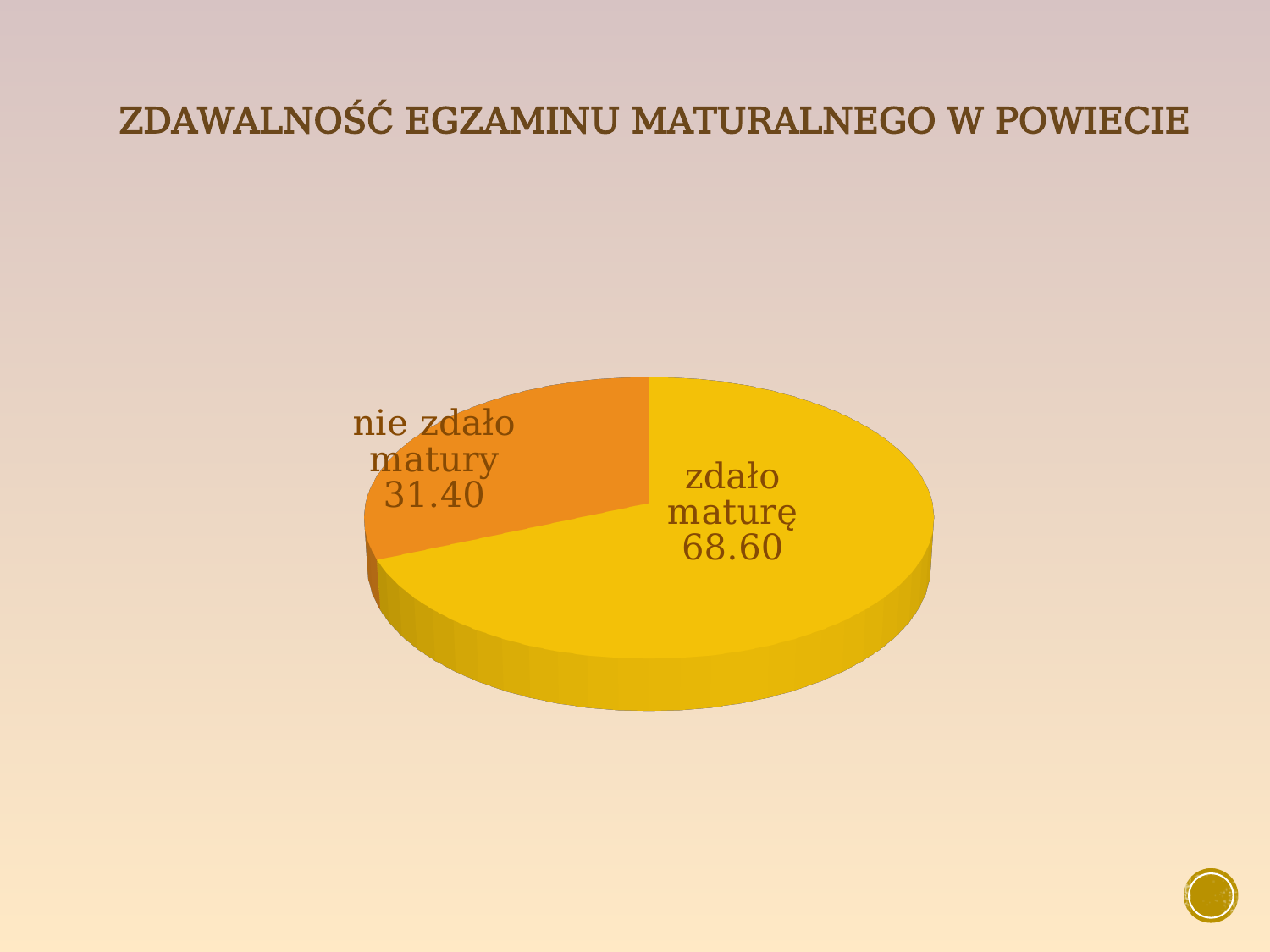
Which is larger: the value for "zdało maturę" or for "nie zdało matury"? zdało maturę How many slices does the pie chart have? 2 What is the difference between the values for "zdało maturę" and "nie zdało matury"? 37.20 What colour is the "nie zdało matury" slice? orange What is the title of the chart on the slide? ZDAWALNOŚĆ EGZAMINU MATURALNEGO W POWIECIE What kind of chart is shown on the slide? pie chart What is the total of the two values shown on the pie chart? 100.00 What value is shown for the "zdało maturę" slice? 68.60 What value is shown for the "nie zdało matury" slice? 31.40 Which slice of the pie is the largest? zdało maturę Which slice of the pie is the smallest? nie zdało matury